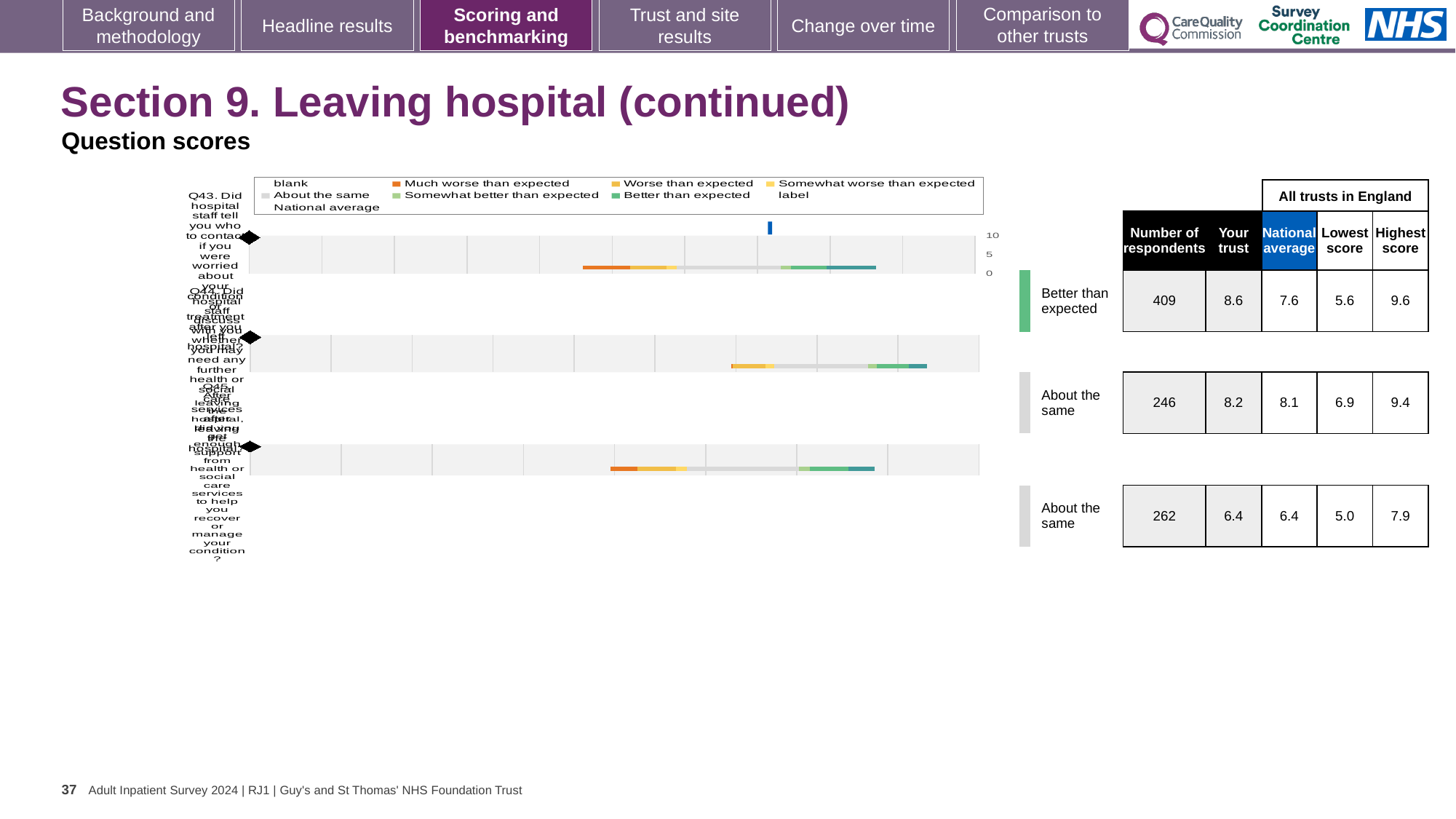
What benchmark category is shown for the first question (Q43)? Better than expected What kind of chart is shown on the slide? bar chart How many question bars are plotted in the chart? 3 How many entries does the chart legend list? 9 Is the 'Your trust' score for the second question (Q44) higher or lower than its national average? higher What is the highest score across all trusts in England for the third question (Q45)? 7.9 What is the national average for the first question (Q43) in the table? 7.6 Which question has the lowest number of respondents in the table? Q44 How many respondents are listed for the second question (Q44)? 246 What is the difference between the 'Your trust' score and the national average for the first question (Q43)? 1.0 Which question has the highest 'Your trust' score in the table? Q43 What is the 'Your trust' score for the first question (Q43) in the table? 8.6